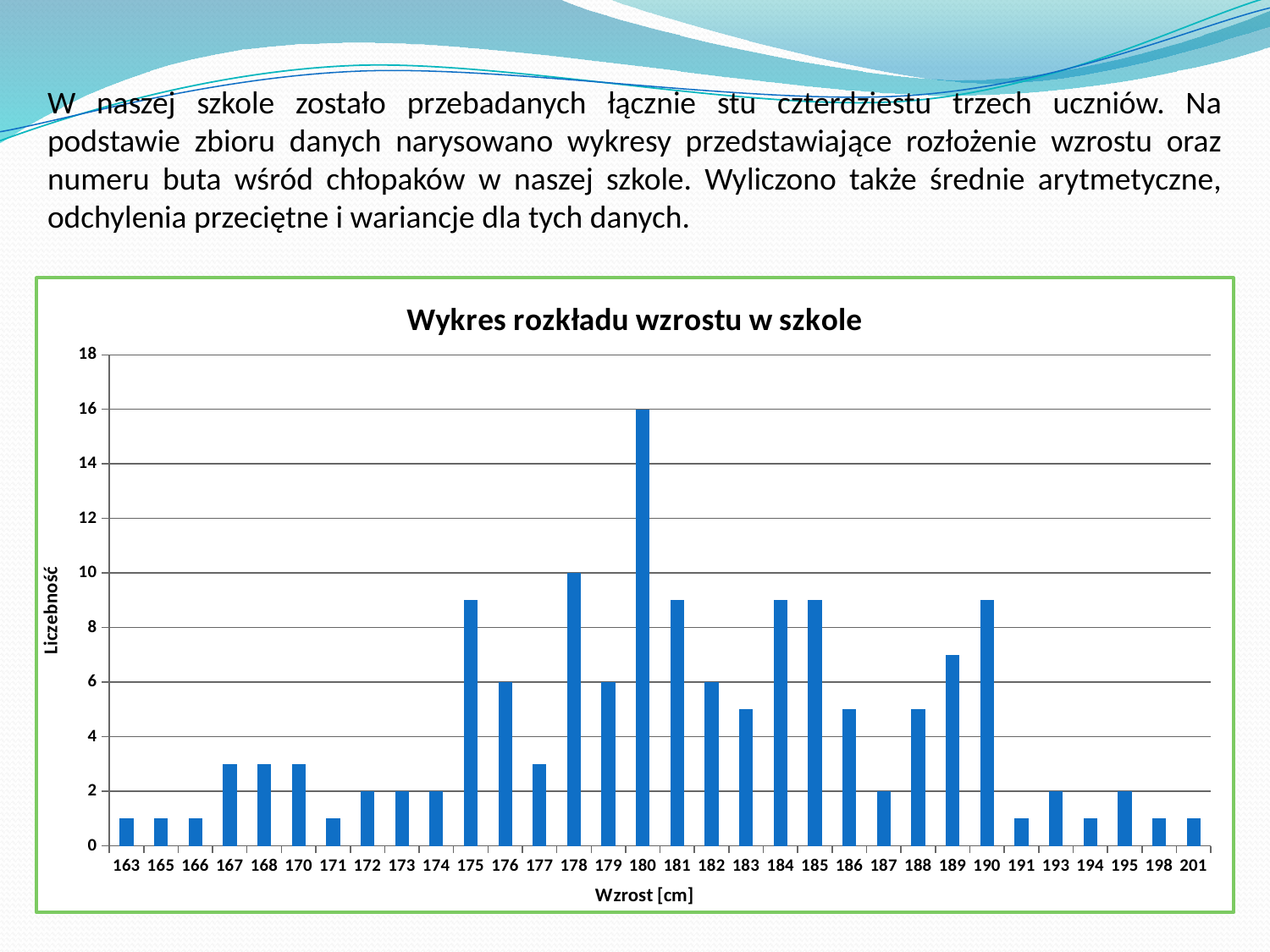
What is the title of the chart? Wykres rozkładu wzrostu w szkole What is the Liczebność for height 176 cm? 6 Which height (Wzrost) has the highest Liczebność? 180 What is the Liczebność for height 180 cm? 16 What is the Liczebność for height 178 cm? 10 What type of chart is shown on the slide? bar chart How many height categories are shown on the x axis? 32 What is the Liczebność for height 172 cm? 2 Which has a larger Liczebność, height 176 cm or height 177 cm? 176 What is the difference in Liczebność between height 180 cm and height 178 cm? 6 Is the Liczebność for height 175 cm greater or less than 8? greater What is the label of the vertical axis? Liczebność